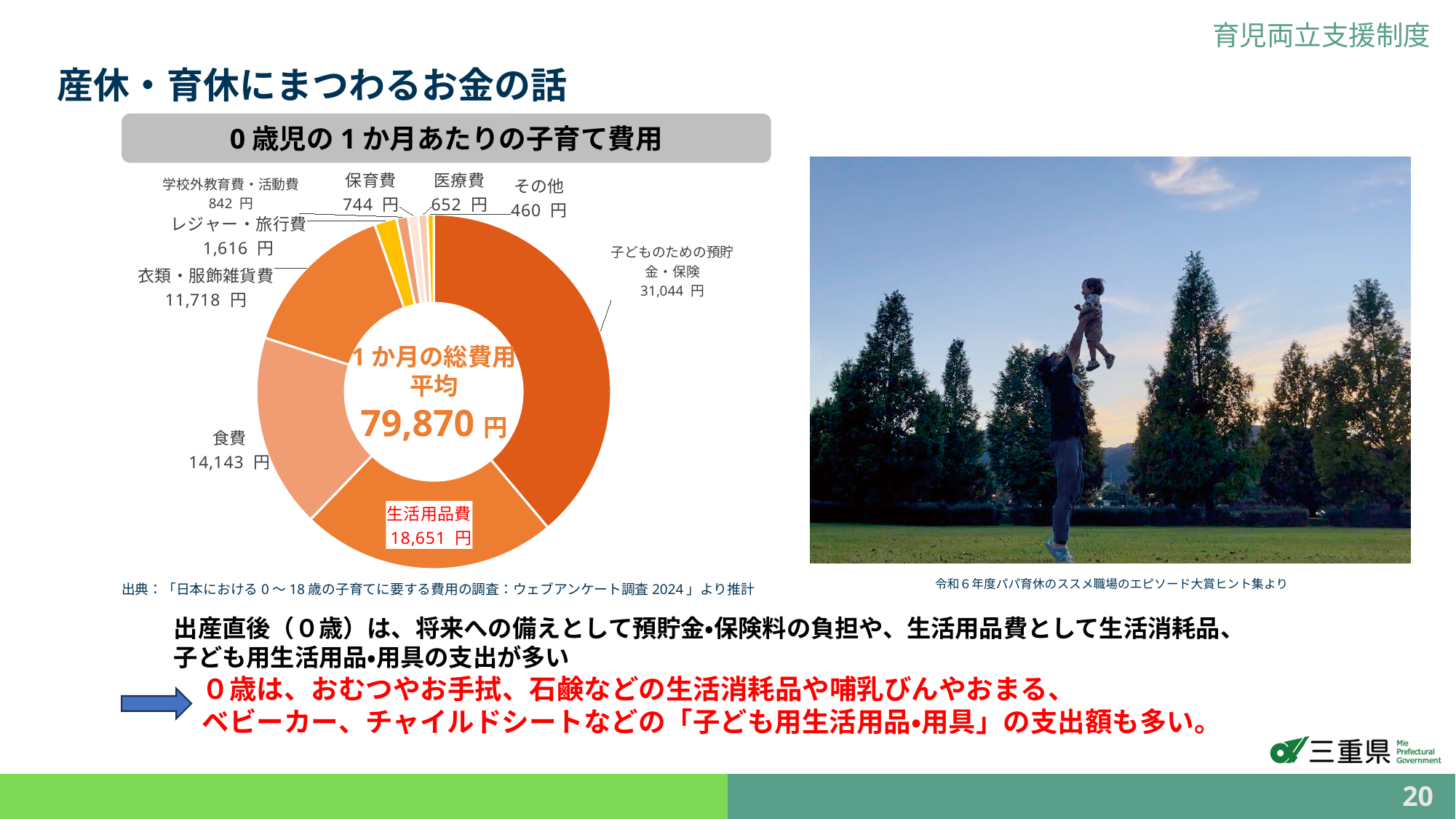
「0歳児の1か月あたりの子育て費用」のグラフで、保育費とレジャー・旅行費ではどちらが大きいですか？ レジャー・旅行費 「0歳児の1か月あたりの子育て費用」のグラフで、衣類・服飾雑貨費の金額はいくらですか？ 11,718 円 「0歳児の1か月あたりの子育て費用」のグラフで、食費の金額はいくらですか？ 14,143 円 「0歳児の1か月あたりの子育て費用」のグラフで、医療費の金額はいくらですか？ 652 円 「0歳児の1か月あたりの子育て費用」のグラフで、最も金額が大きい項目はどれですか？ 子どものための預貯金・保険 「0歳児の1か月あたりの子育て費用」のグラフで、最も金額が小さい項目はどれですか？ その他 「0歳児の1か月あたりの子育て費用」のグラフはどの種類のグラフですか？ 円グラフ（ドーナツグラフ） 「0歳児の1か月あたりの子育て費用」のグラフには、いくつの項目がありますか？ 9 「0歳児の1か月あたりの子育て費用」のグラフで、生活用品費と食費の差はいくらですか？ 4,508 円 「0歳児の1か月あたりの子育て費用」のグラフで、赤い文字でラベルが表示されている項目はどれですか？ 生活用品費 「0歳児の1か月あたりの子育て費用」のグラフの中央に示されている1か月の総費用平均はいくらですか？ 79,870 円